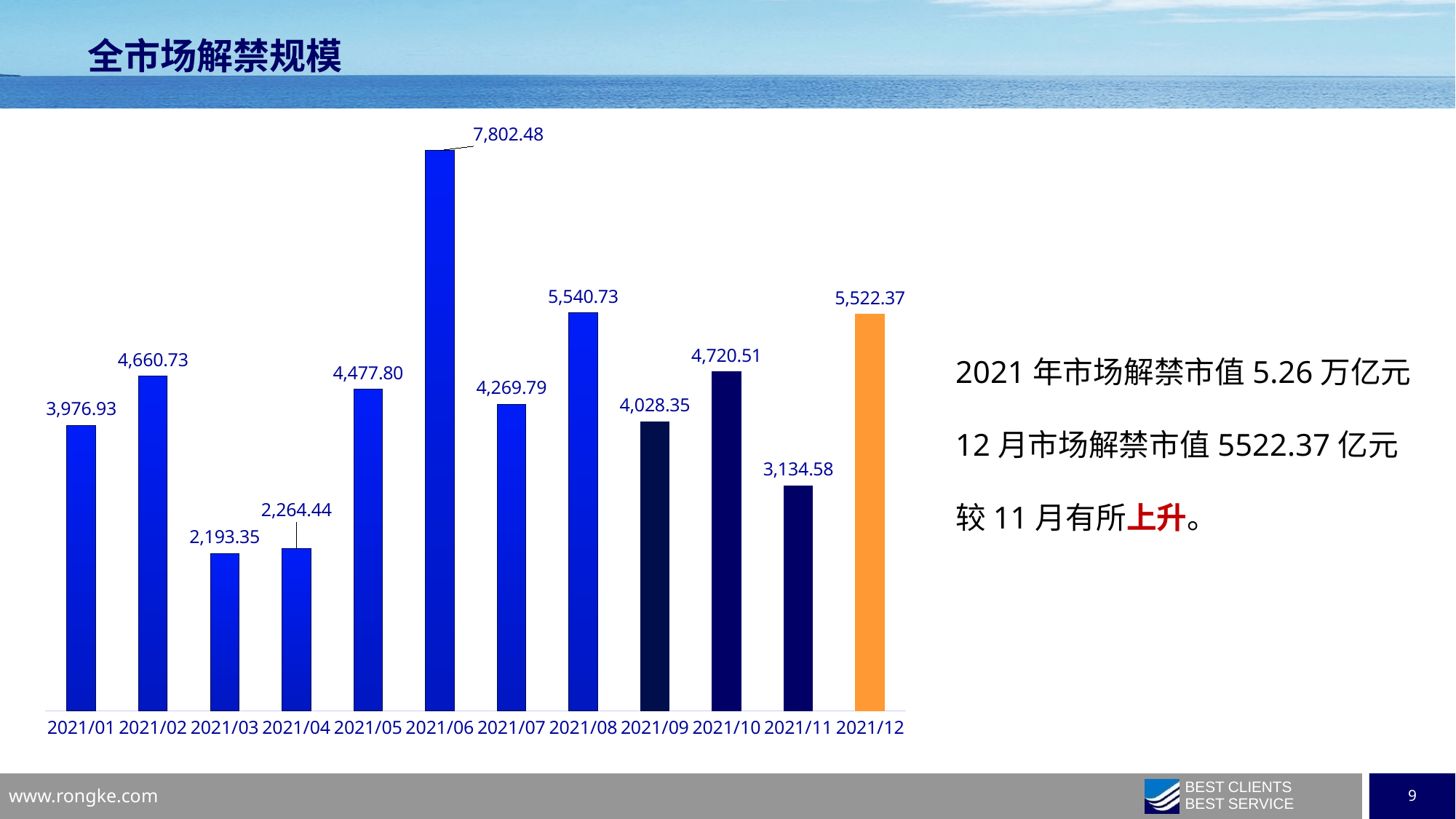
What is the difference between the values for 2021/06 and 2021/08? 2,261.75 Do the values rise or fall from 2021/03 to 2021/06? Rise What kind of chart is shown on the slide? Bar chart Which month has the lowest value? 2021/03 How many months are shown on the x axis? 12 What is the value for 2021/06? 7,802.48 Which is larger, the value for 2021/01 or the value for 2021/05? 2021/05 What is the value for 2021/12? 5,522.37 Which month's bar is coloured orange? 2021/12 What is the value for 2021/03? 2,193.35 Which month has the highest value? 2021/06 What is the difference between the values for 2021/12 and 2021/11? 2,387.79